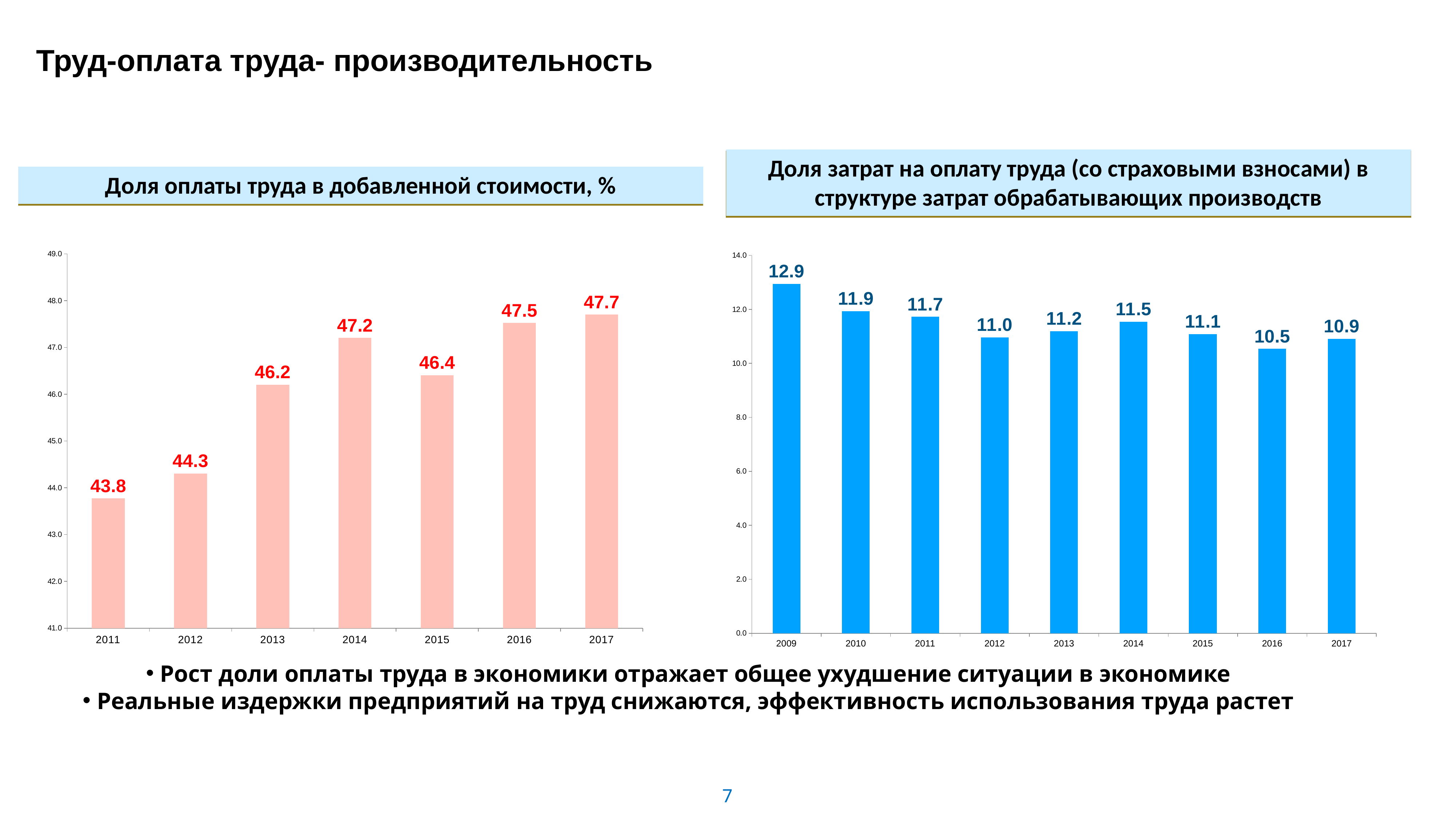
In the right chart (Доля затрат на оплату труда), what is the difference between the values for 2009 and 2017? 2.0 In the left chart (Доля оплаты труда в добавленной стоимости, %), what is the difference between the values for 2017 and 2011? 3.9 In the right chart (Доля затрат на оплату труда), what is the value for 2009? 12.9 In the left chart (Доля оплаты труда в добавленной стоимости, %), how many years are shown? 7 In the left chart (Доля оплаты труда в добавленной стоимости, %), what is the value for 2011? 43.8 In the left chart (Доля оплаты труда в добавленной стоимости, %), what is the value for 2015? 46.4 In the right chart (Доля затрат на оплату труда), what is the value for 2016? 10.5 In the left chart (Доля оплаты труда в добавленной стоимости, %), which year has the highest value? 2017 In the right chart (Доля затрат на оплату труда), which year has the lowest value? 2016 In the left chart (Доля оплаты труда в добавленной стоимости, %), which year has the lowest value? 2011 What kind of chart is the right chart (Доля затрат на оплату труда)? Bar chart In the right chart (Доля затрат на оплату труда), which is larger, the value for 2014 or the value for 2012? 2014